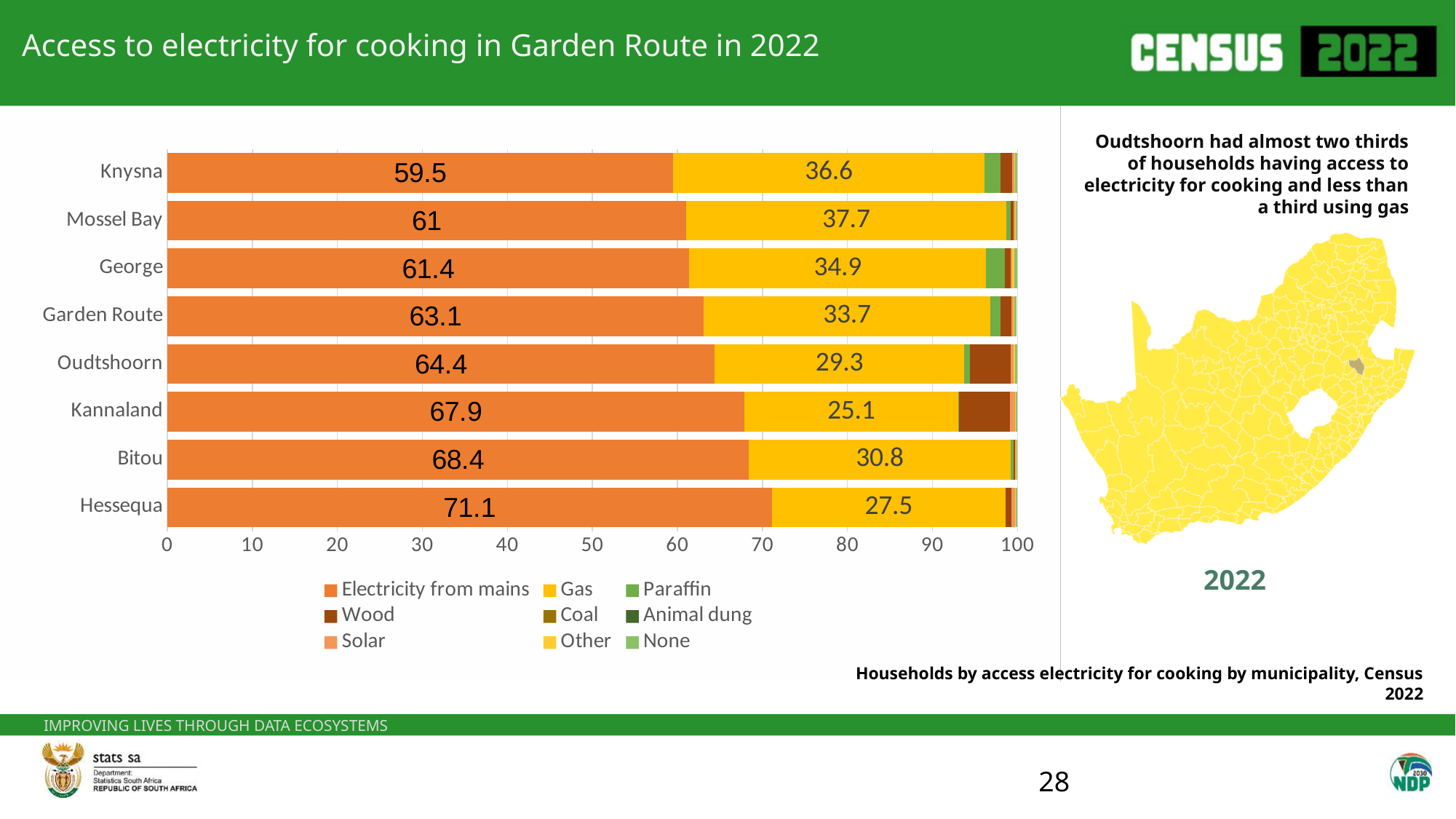
Which municipality has the highest Gas value? Mossel Bay What is the Electricity from mains value for Hessequa? 71.1 Which has a larger Electricity from mains value, Bitou or Garden Route? Bitou How many municipalities/areas are shown on the chart? 8 How many series does the legend list? 9 What is the value for Electricity from mains for Knysna? 59.5 Which municipality has the lowest Electricity from mains value? Knysna What kind of chart is shown on the slide? Stacked bar chart What is the difference between the Electricity from mains values for Hessequa and Knysna? 11.6 Which municipality has the highest Electricity from mains value? Hessequa What is the Gas value for Kannaland? 25.1 What is the Gas value for Oudtshoorn? 29.3